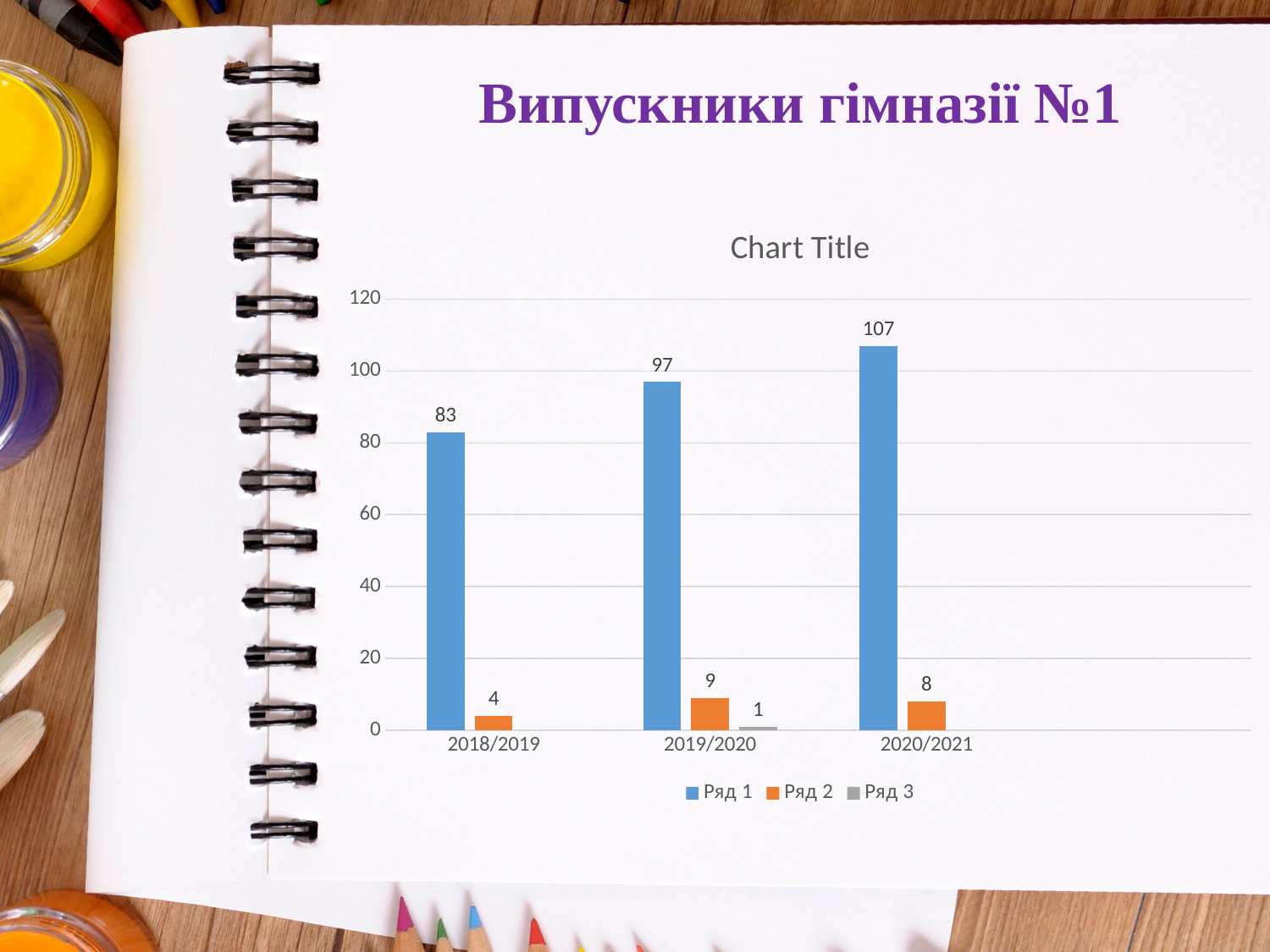
Which is larger, the Ряд 2 value for 2019/2020 or for 2020/2021? 2019/2020 Is the value of Ряд 1 for 2019/2020 greater or less than 100? less How many year categories are shown on the x axis? 3 What is the value of Ряд 1 for 2018/2019? 83 Does the value of Ряд 1 rise or fall from 2018/2019 to 2020/2021? rise What is the value of Ряд 3 for 2019/2020? 1 What is the value of Ряд 1 for 2020/2021? 107 Which year has the lowest value for Ряд 2? 2018/2019 What is the difference between the Ряд 1 values for 2020/2021 and 2018/2019? 24 How many series does the legend list? 3 What is the value of Ряд 2 for 2019/2020? 9 Which year has the highest value for Ряд 1? 2020/2021